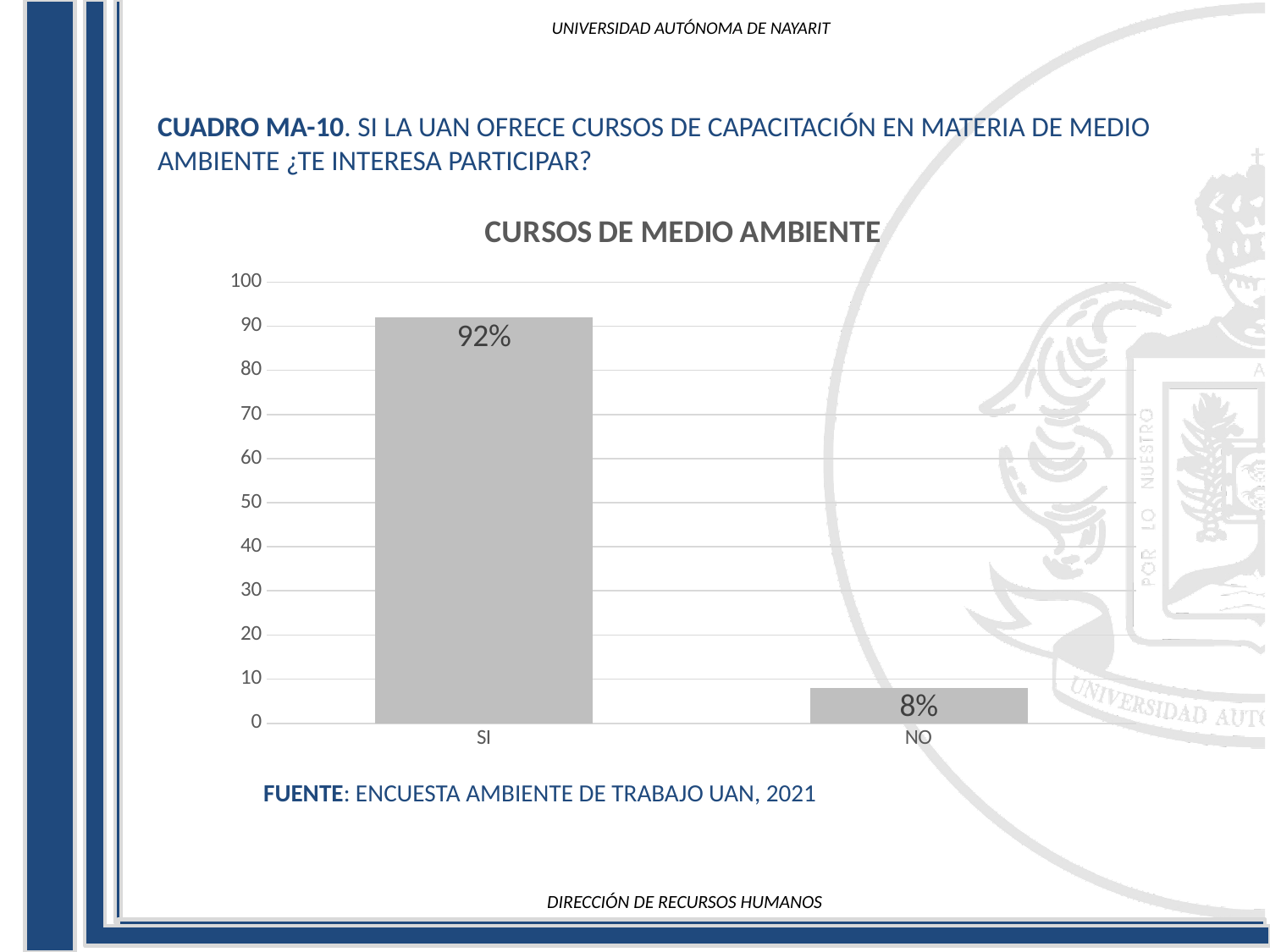
Which category has the highest value? SI What is the highest value shown on the y axis? 100 Is the value for SI greater or less than 50? greater What kind of chart is shown? bar chart Which is larger, the value for SI or the value for NO? SI Which category has the lowest value? NO What is the difference between the values for SI and NO? 84% What is the title of the chart? CURSOS DE MEDIO AMBIENTE How many categories are shown on the x axis? 2 What is the value for NO? 8% Is the value for NO greater or less than 10? less What is the value for SI? 92%